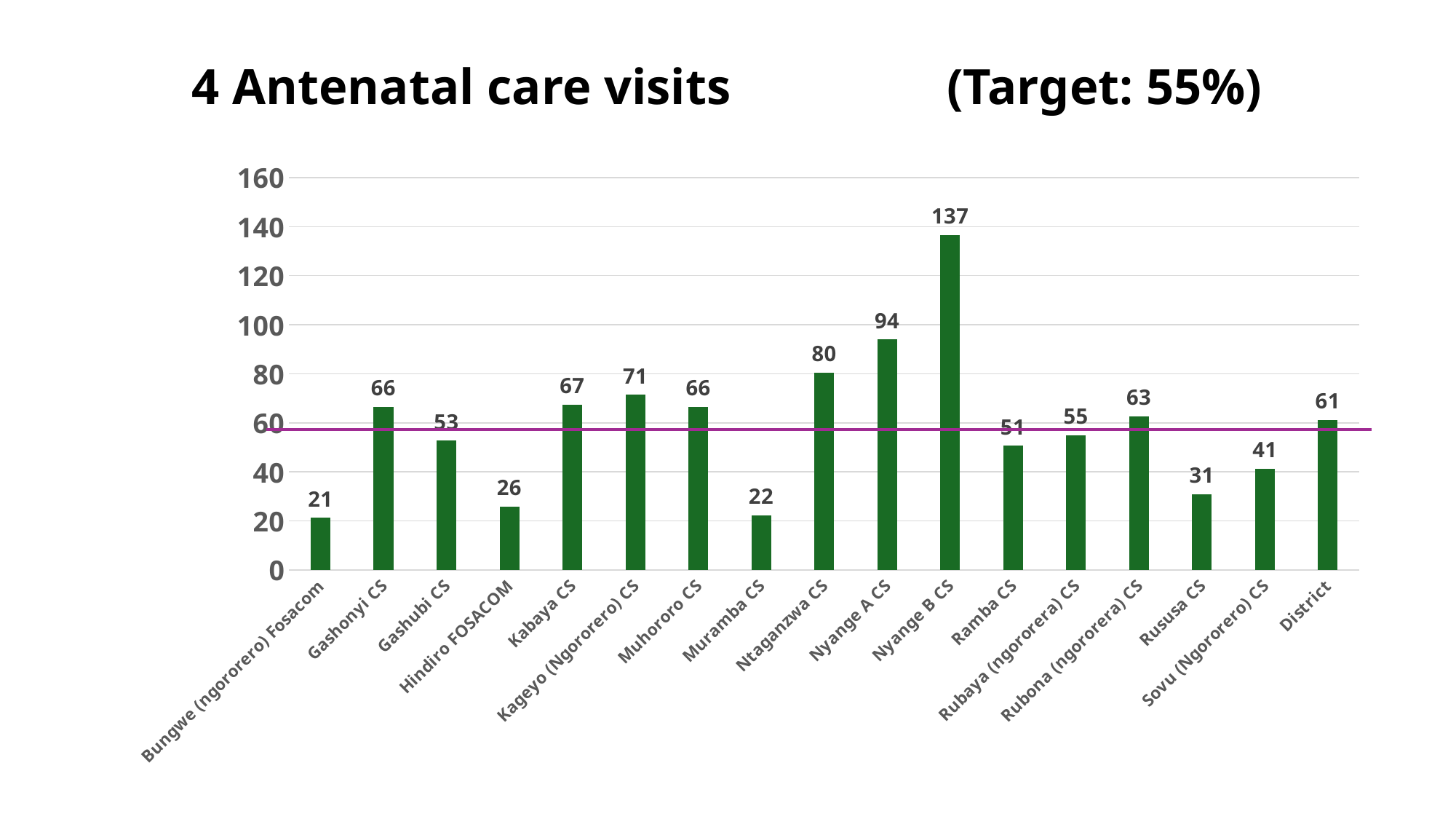
Which is larger, the value for Rususa CS or the value for Sovu (Ngororero) CS? Sovu (Ngororero) CS What colour are the bars in the chart? Green Which category has the lowest value? Bungwe (ngororero) Fosacom Is the value for Ntaganzwa CS greater or less than 60? greater What is the value for Nyange B CS? 137 What is the value for District? 61 Which category has the highest value? Nyange B CS How many categories are shown on the x axis? 17 What is the value for Hindiro FOSACOM? 26 What kind of chart is shown on the slide? Bar chart What is the title of the chart? 4 Antenatal care visits (Target: 55%) What is the difference between the values for Nyange B CS and Nyange A CS? 43